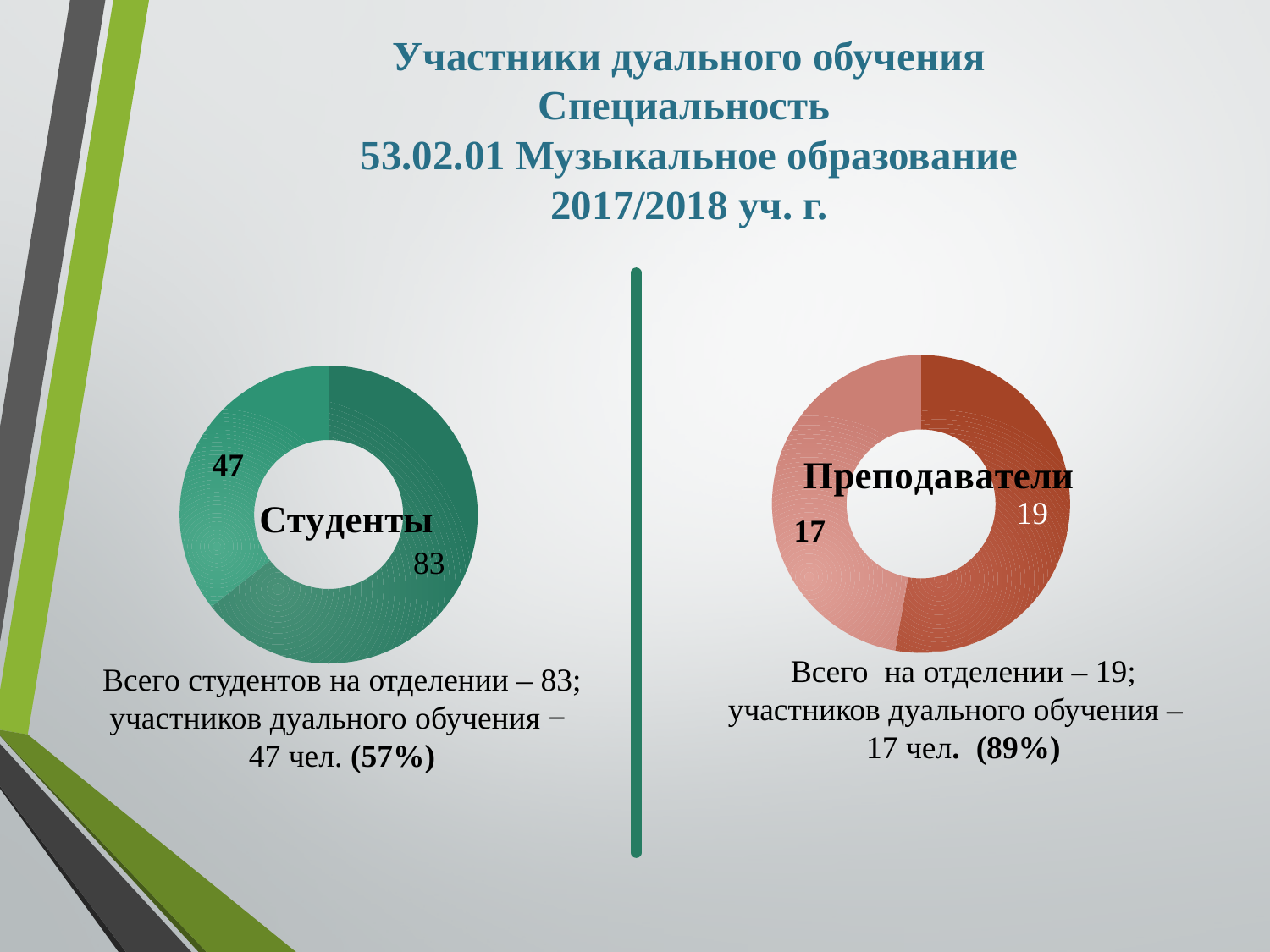
On the Преподаватели chart, what is the difference between the two labelled values, 19 and 17? 2 What kind of chart is the Преподаватели chart? doughnut chart On the Преподаватели chart, what value is shown for the darker red slice? 19 How many slices does the Студенты chart have? 2 On the Студенты chart, what value is shown for the darker green slice? 83 According to the slide, what share of the 19 teachers on the department are participants in dual training? 89% On the Преподаватели chart, what value is shown for the lighter red slice? 17 On the Студенты chart, which of the two labelled values is larger, 47 or 83? 83 What colour are the slices of the chart on the right side of the slide? red On the Студенты chart, what is the difference between the two labelled values, 83 and 47? 36 On the Студенты chart, what value is shown for the lighter green slice? 47 According to the slide, what share of the 83 students on the department are participants in dual training? 57%